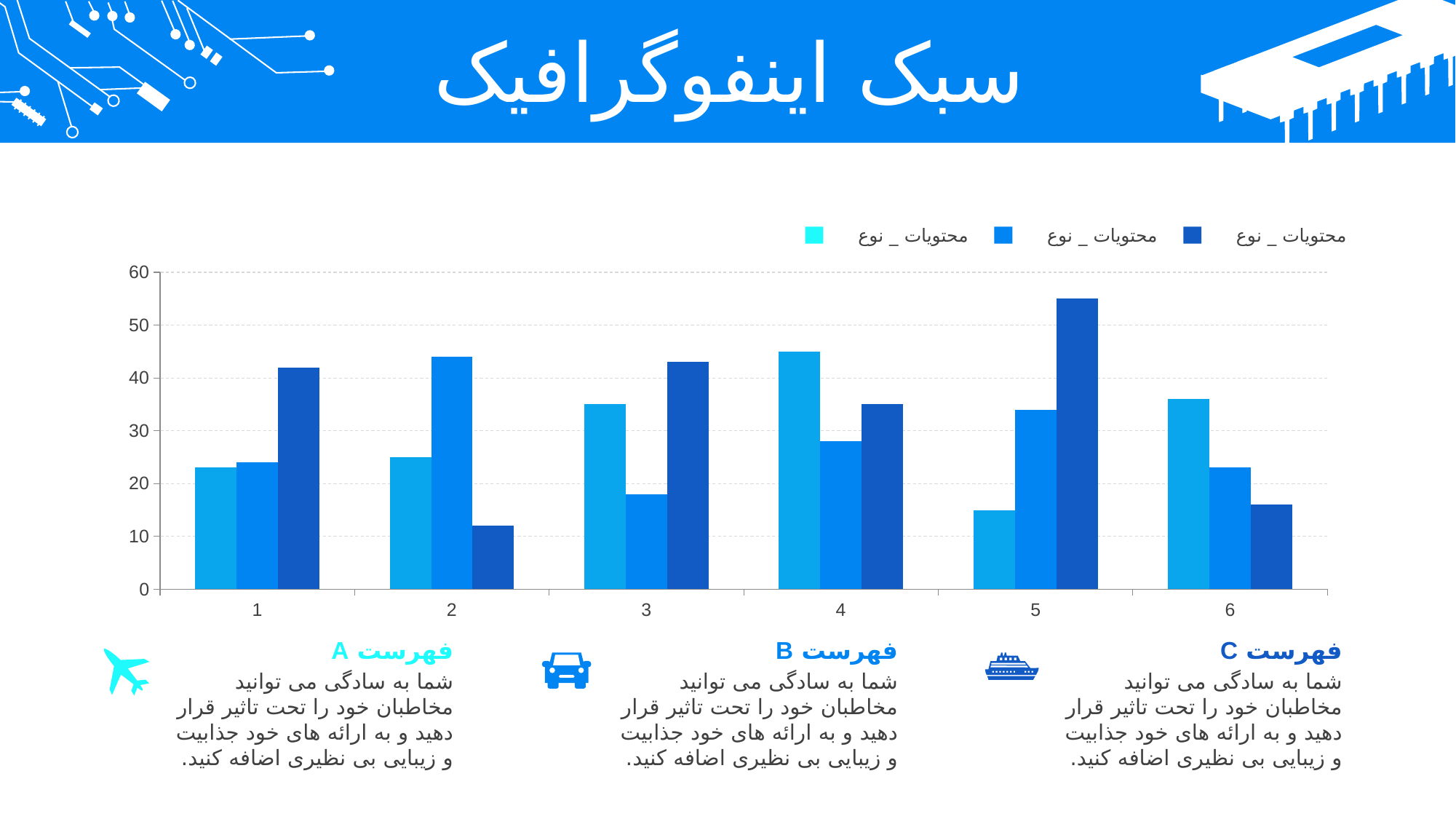
Is the value of the cyan bar for category 5 greater or less than 20? less Is the value of the cyan bar for category 4 greater or less than 40? greater What kind of chart is shown on the slide? bar chart For category 3, which bar is larger: the cyan bar or the medium blue bar? the cyan bar What is the highest value shown on the chart's vertical axis? 60 How many categories are shown on the x axis of the chart? 6 Is the value of the dark blue bar for category 5 greater or less than 50? greater How many series does the chart's legend list? 3 For which category is the dark blue bar the lowest? 2 For which category is the dark blue bar the highest? 5